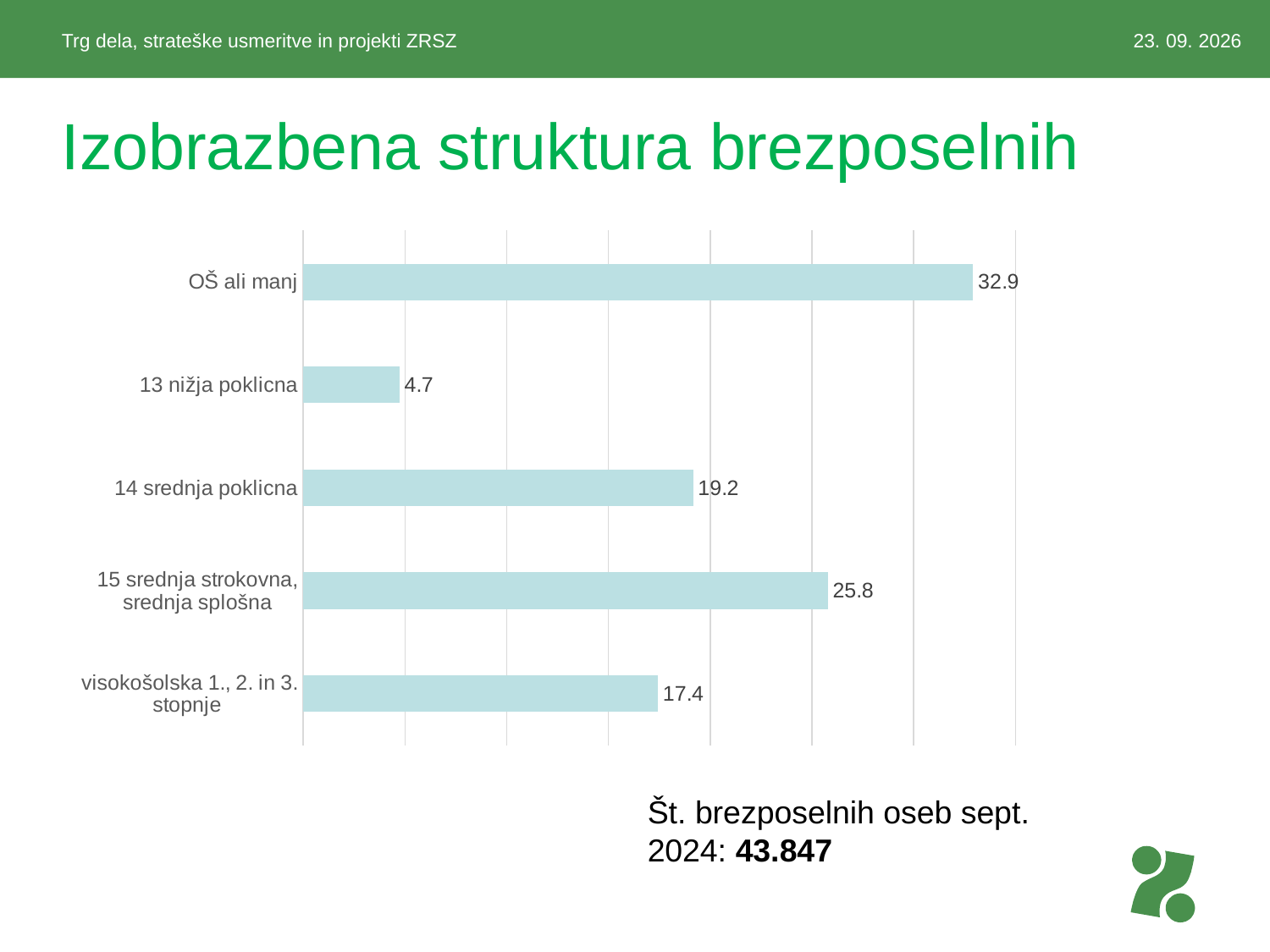
Which category has the lowest value? 13 nižja poklicna What kind of chart is shown on the slide? bar chart Which is larger, the value for "14 srednja poklicna" or the value for "visokošolska 1., 2. in 3. stopnje"? 14 srednja poklicna What is the difference between the values for "OŠ ali manj" and "13 nižja poklicna"? 28.2 What is the value for "visokošolska 1., 2. in 3. stopnje"? 17.4 How many categories are shown in the chart? 5 What is the value for "13 nižja poklicna"? 4.7 What is the value for "14 srednja poklicna"? 19.2 Which category has the highest value? OŠ ali manj What is the value for "15 srednja strokovna, srednja splošna"? 25.8 What is the difference between the values for "15 srednja strokovna, srednja splošna" and "14 srednja poklicna"? 6.6 What is the value for "OŠ ali manj"? 32.9